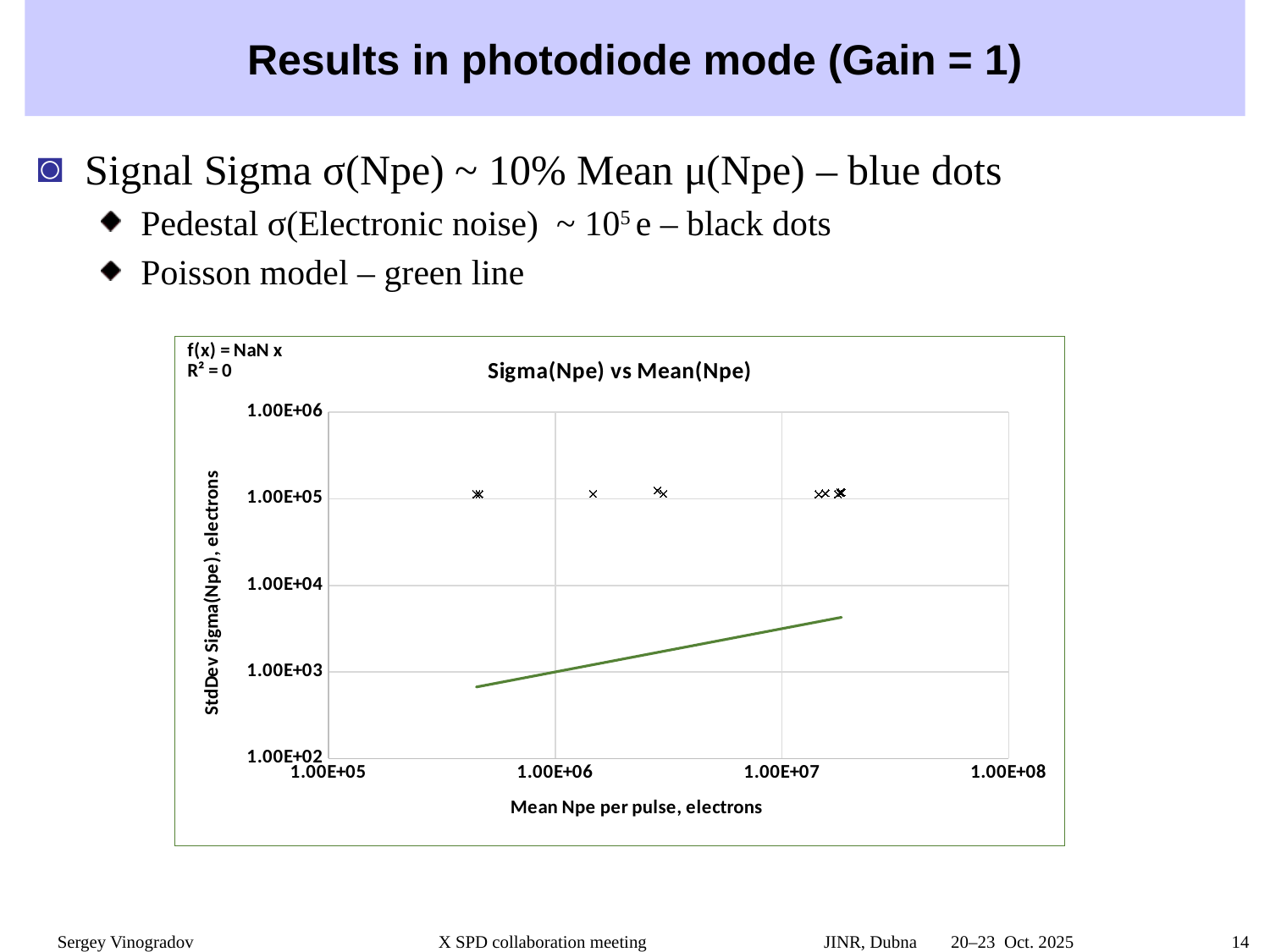
What is the label of the x axis of the chart? Mean Npe per pulse, electrons What is the highest tick label shown on the y axis of the chart? 1.00E+06 Does the green line rise or fall as the mean Npe per pulse increases? Rises Is the value of the green line at its left end greater or less than 1.00E+03? less Near a mean Npe of 1.00E+06, which is higher: the black markers or the green line? The black markers Is the value of the green line at its right end greater or less than 1.00E+04? less Is the value of the green line at its right end greater or less than 1.00E+03? greater What is the lowest tick label shown on the x axis of the chart? 1.00E+05 How many tick labels are shown on the x axis of the chart? 4 What is the title of the chart on the slide? Sigma(Npe) vs Mean(Npe) What kind of chart is shown on the slide? Scatter chart